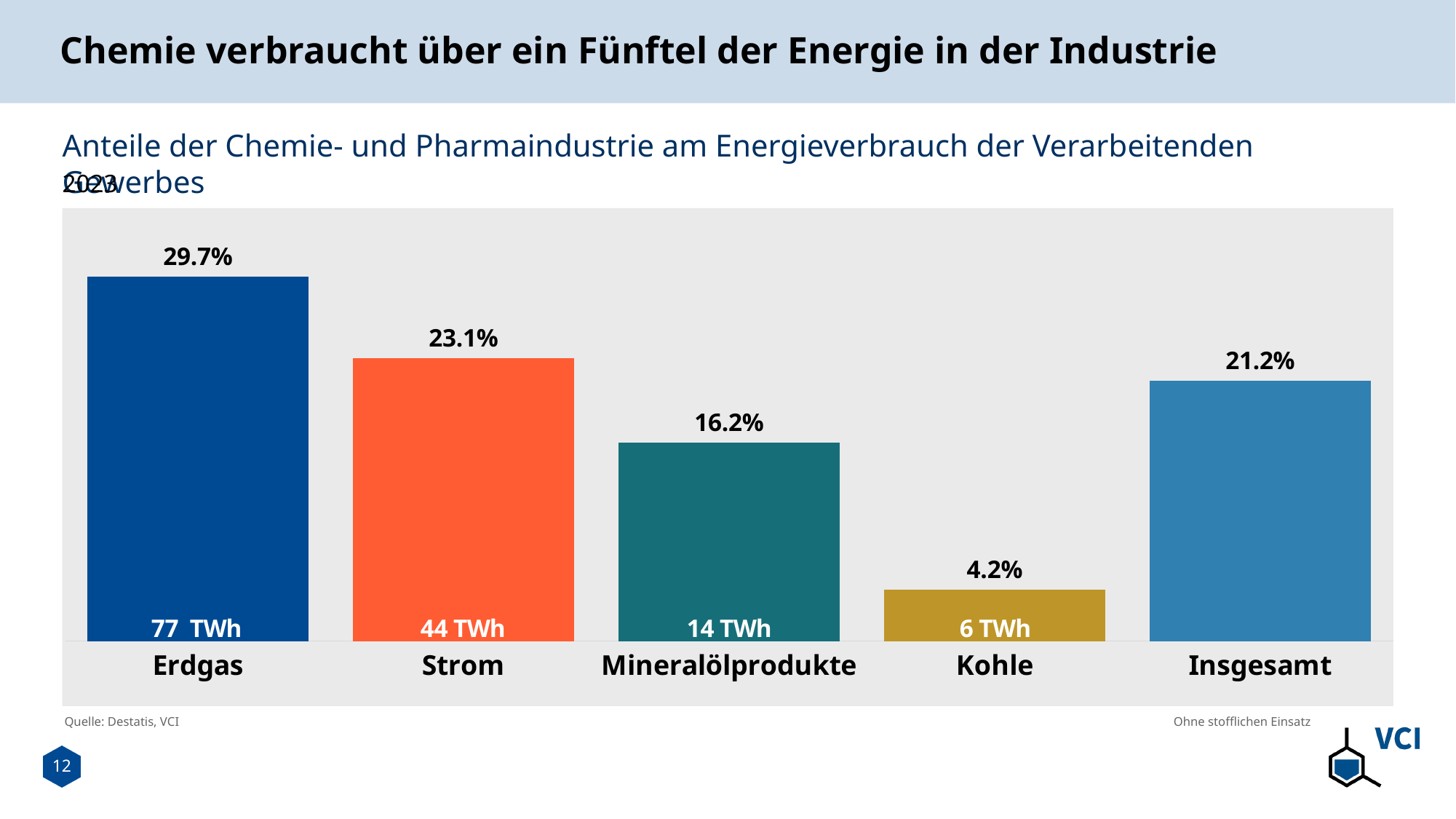
What source is cited below the chart? Destatis, VCI How many TWh are shown inside the Erdgas bar? 77 TWh What kind of chart is shown on the slide? Bar chart Which category has the lowest percentage share? Kohle What is the percentage share shown for Erdgas? 29.7% What is the percentage share shown for Kohle? 4.2% What is the difference in percentage points between the Erdgas share and the Strom share? 6.6 How many TWh are shown inside the Mineralölprodukte bar? 14 TWh How many categories are shown on the x axis? 5 What is the percentage share shown for Strom? 23.1% Which category has the highest percentage share? Erdgas Which has a larger percentage share, Mineralölprodukte or Insgesamt? Insgesamt